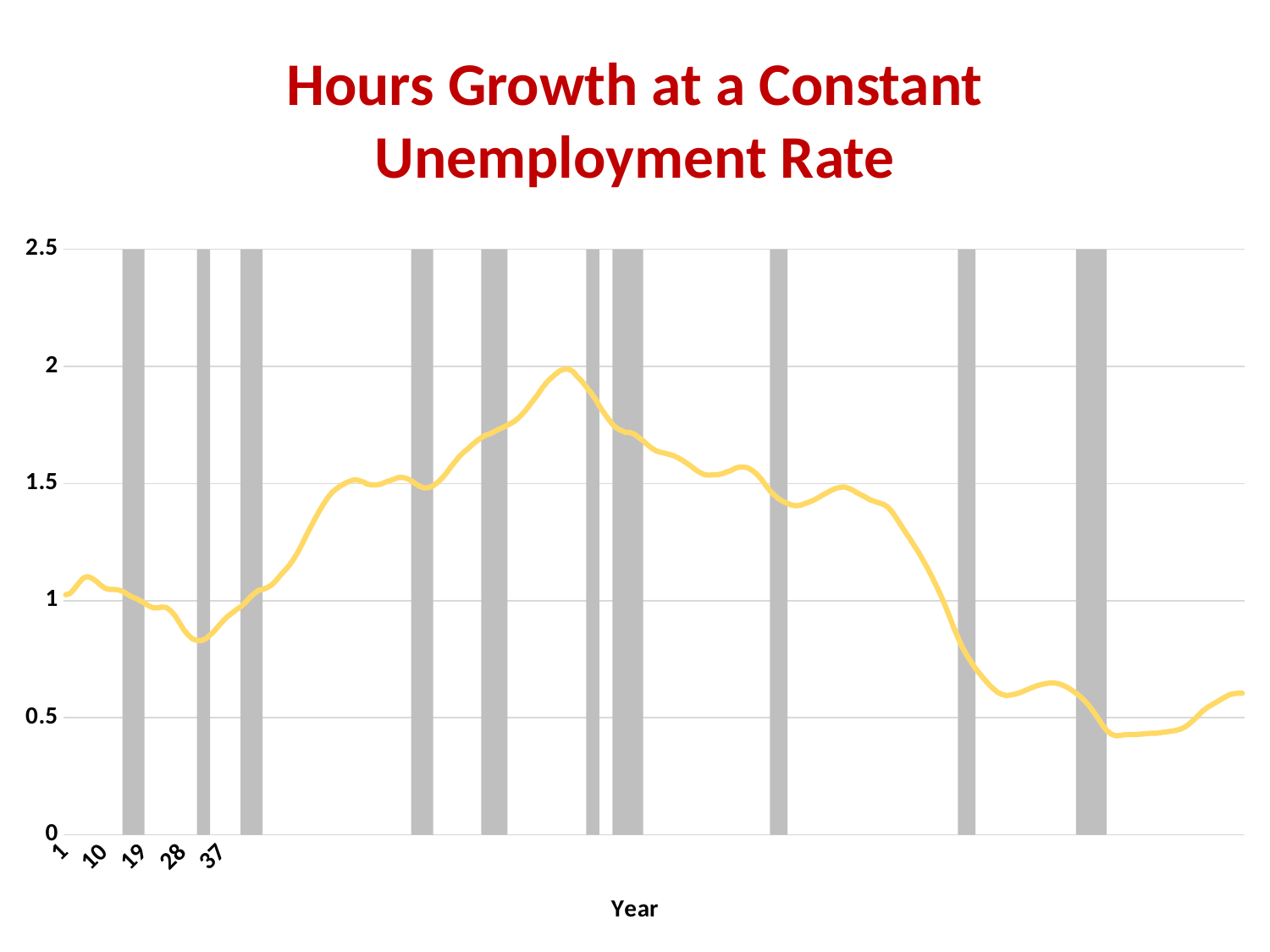
Is the value at the last point on the right of the chart greater or less than 1? less Is the value at the first point (year 1) greater or less than 1.5? less Does the line rise or fall over the final third of the x axis? fall Is the value at year 28 greater or less than 1? less What is the label on the x axis of the chart? Year Comparing the first point and the last point of the line, which is higher? the first point What kind of chart is shown on the slide? line chart What is the title of the chart? Hours Growth at a Constant Unemployment Rate What is the highest value shown on the y axis? 2.5